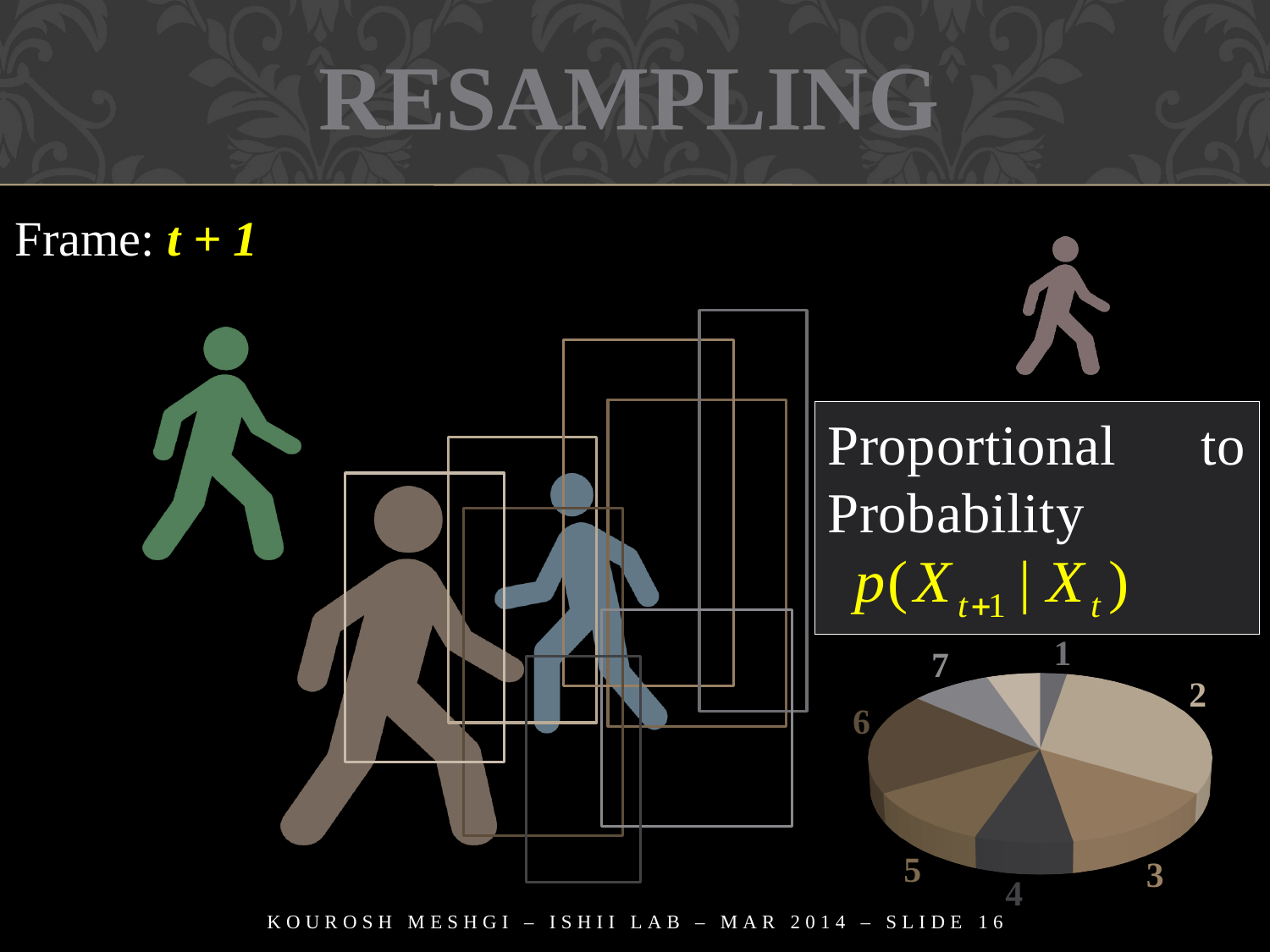
In the pie chart, which slice is larger, slice 6 or slice 1? 6 What kind of chart is shown at the bottom right of the slide? pie chart Which slice of the pie chart is the smallest? 1 How many slices does the pie chart have? 8 In the pie chart, which slice is larger, slice 4 or slice 1? 4 Is the pie chart drawn in 3D or flat 2D? 3D In the pie chart, which slice is larger, slice 3 or slice 7? 3 What labels are used for the slices of the pie chart? the numbers 1 to 7